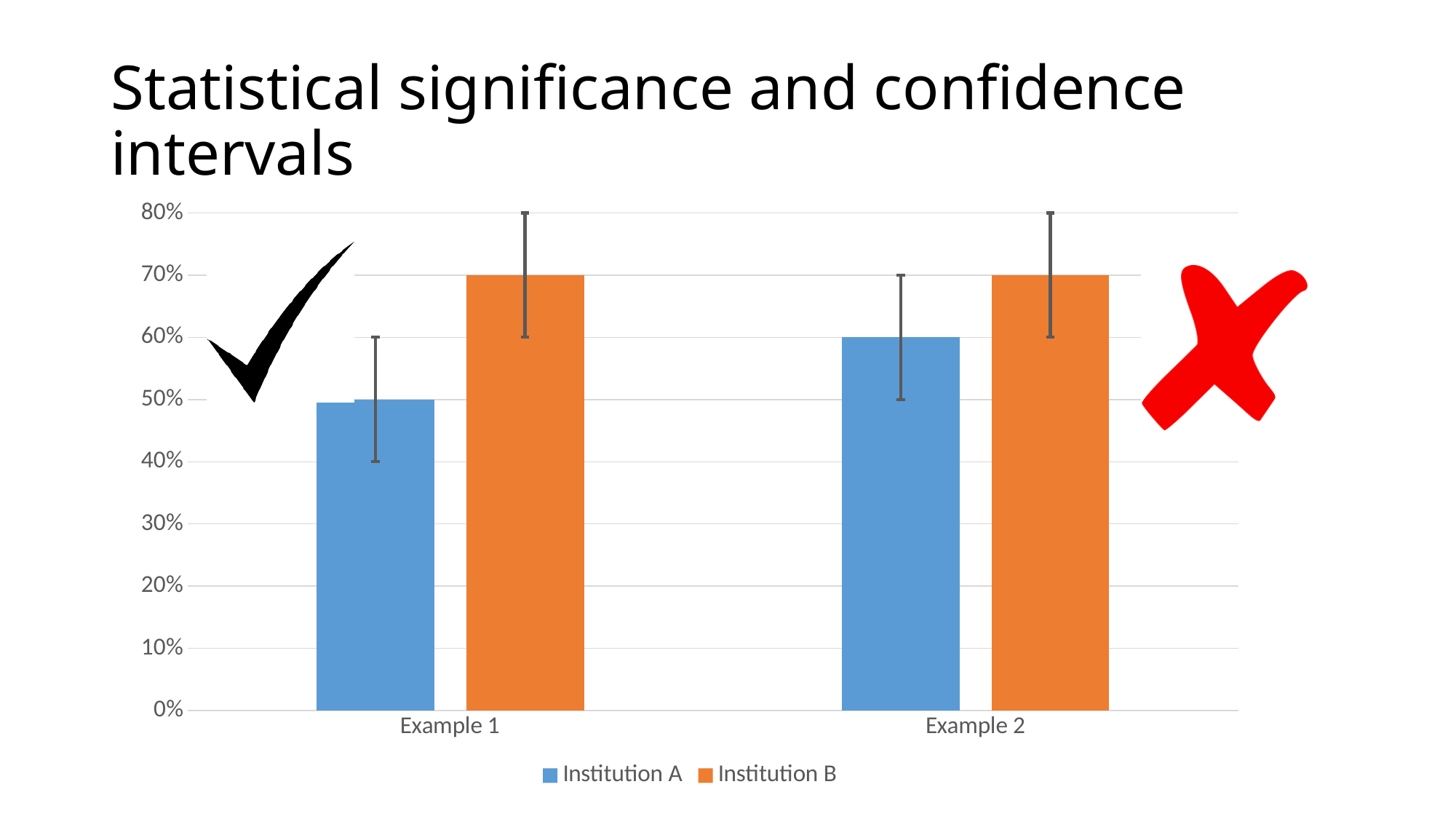
What kind of chart is shown on the slide? bar chart What is the value for Institution A in Example 2? 60% What is the value for Institution B in Example 1? 70% What is the difference between Institution B and Institution A in Example 1? 20% What is the value for Institution B in Example 2? 70% Which institution has the higher value in Example 2? Institution B Which bar is the lowest in the chart? Institution A in Example 1 What is the value for Institution A in Example 1? 50% How many series does the legend list? 2 How many categories are shown on the x axis? 2 Which series is shown in orange? Institution B What is the difference between Institution B and Institution A in Example 2? 10%